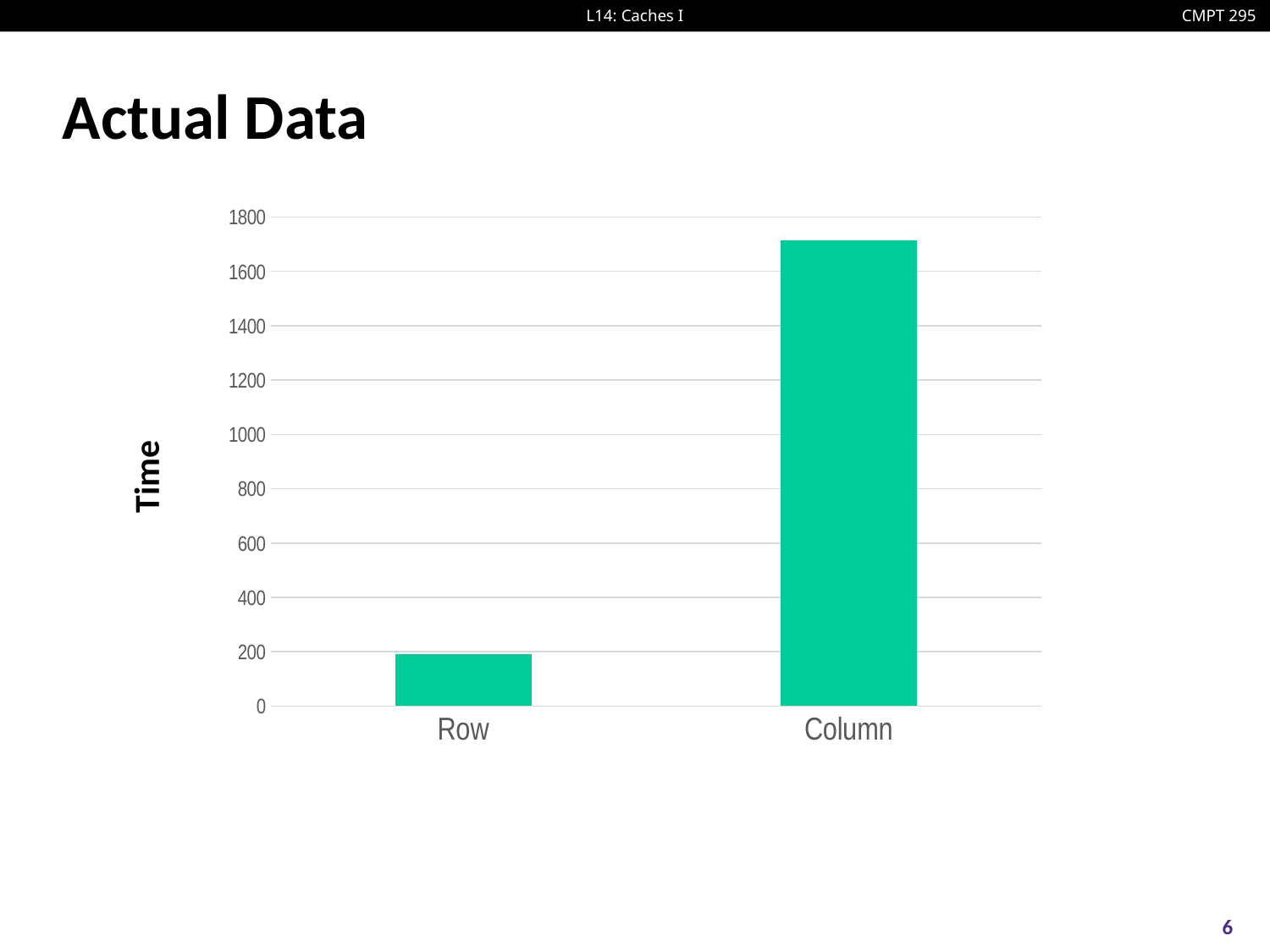
What kind of chart is shown on the slide? bar chart Which is larger, the value for Row or the value for Column? Column Is the value for Row greater or less than 400? less What is the label on the vertical axis of the chart? Time Do the values rise or fall from Row to Column along the x axis? rise Which category has the highest value? Column How many categories are plotted on the chart? 2 Is the value for Column greater or less than 1800? less What is the title of the slide containing the chart? Actual Data Which category has the lowest value? Row Is the value for Column greater or less than 1600? greater